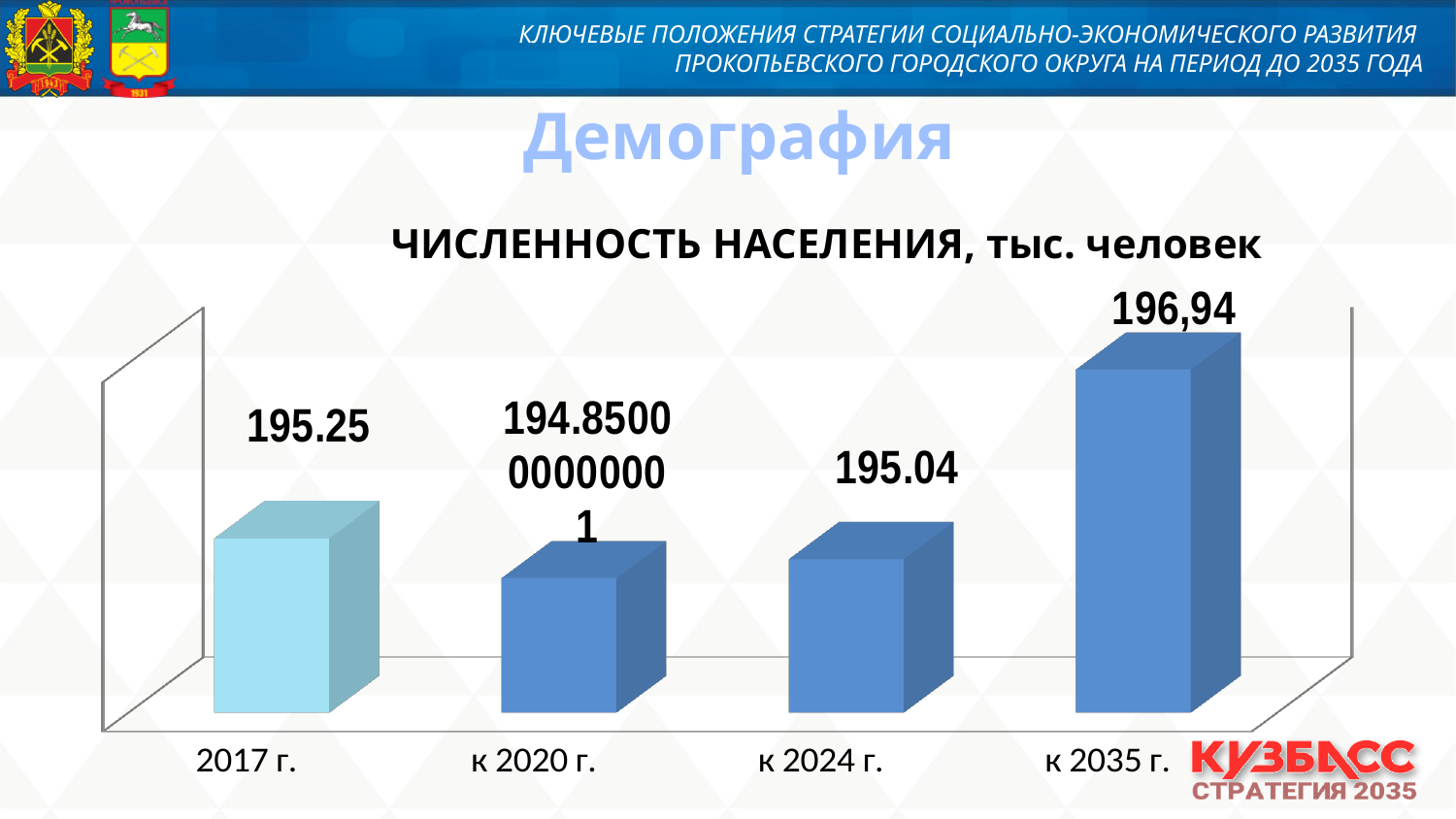
Which category has the highest population value? к 2035 г. What is the title of the chart? ЧИСЛЕННОСТЬ НАСЕЛЕНИЯ, тыс. человек What is the population value shown for к 2024 г.? 195.04 Which is larger, the value for 2017 г. or the value for к 2024 г.? 2017 г. What is the population value shown for 2017 г.? 195.25 What is the difference between the values for 2017 г. and к 2024 г.? 0.21 What is the difference between the values for к 2035 г. and 2017 г.? 1.69 Which category has the lowest population value? к 2020 г. Does the value rise or fall from к 2024 г. to к 2035 г.? Rises What is the population value shown for к 2035 г.? 196,94 How many categories are shown on the x axis? 4 What kind of chart is shown on the slide? Bar chart